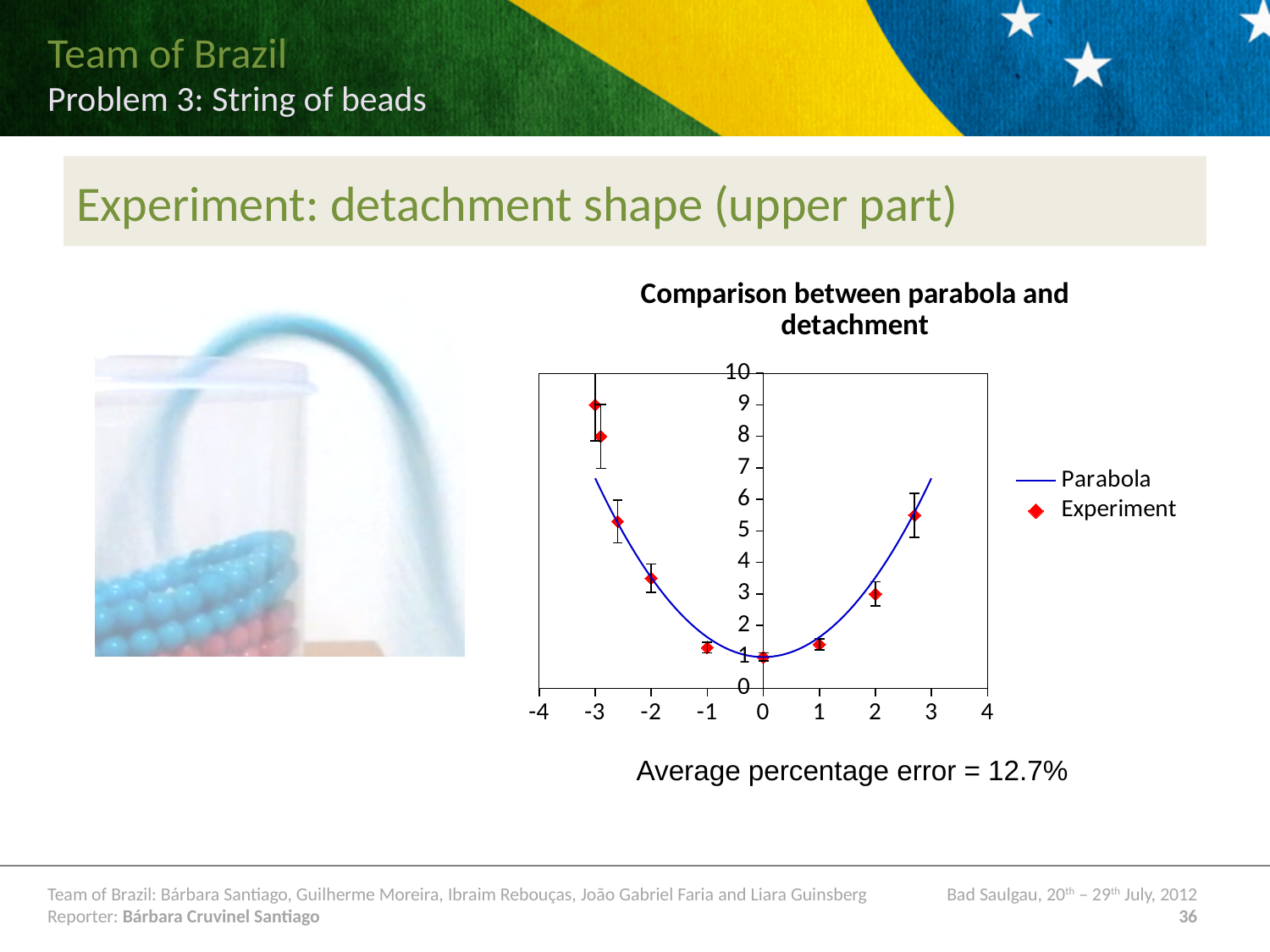
What are the two entries in the chart's legend? Parabola and Experiment Is the Experiment value at x = -1 greater or less than 2? less Do the Experiment values rise or fall as x increases from 0 to 3? rise What kind of chart is shown on the slide? scatter chart What average percentage error is stated below the chart? 12.7% Which is larger: the Experiment value at x = -3 or the Experiment value near x = 3? x = -3 How many series does the legend of the chart list? 2 Is the Experiment value at x = 0 greater or less than 5? less How many Experiment data points are plotted on the chart? 9 Are the Experiment values at x = -3 greater or less than 7? greater At which x value does the Experiment series reach its highest point? -3